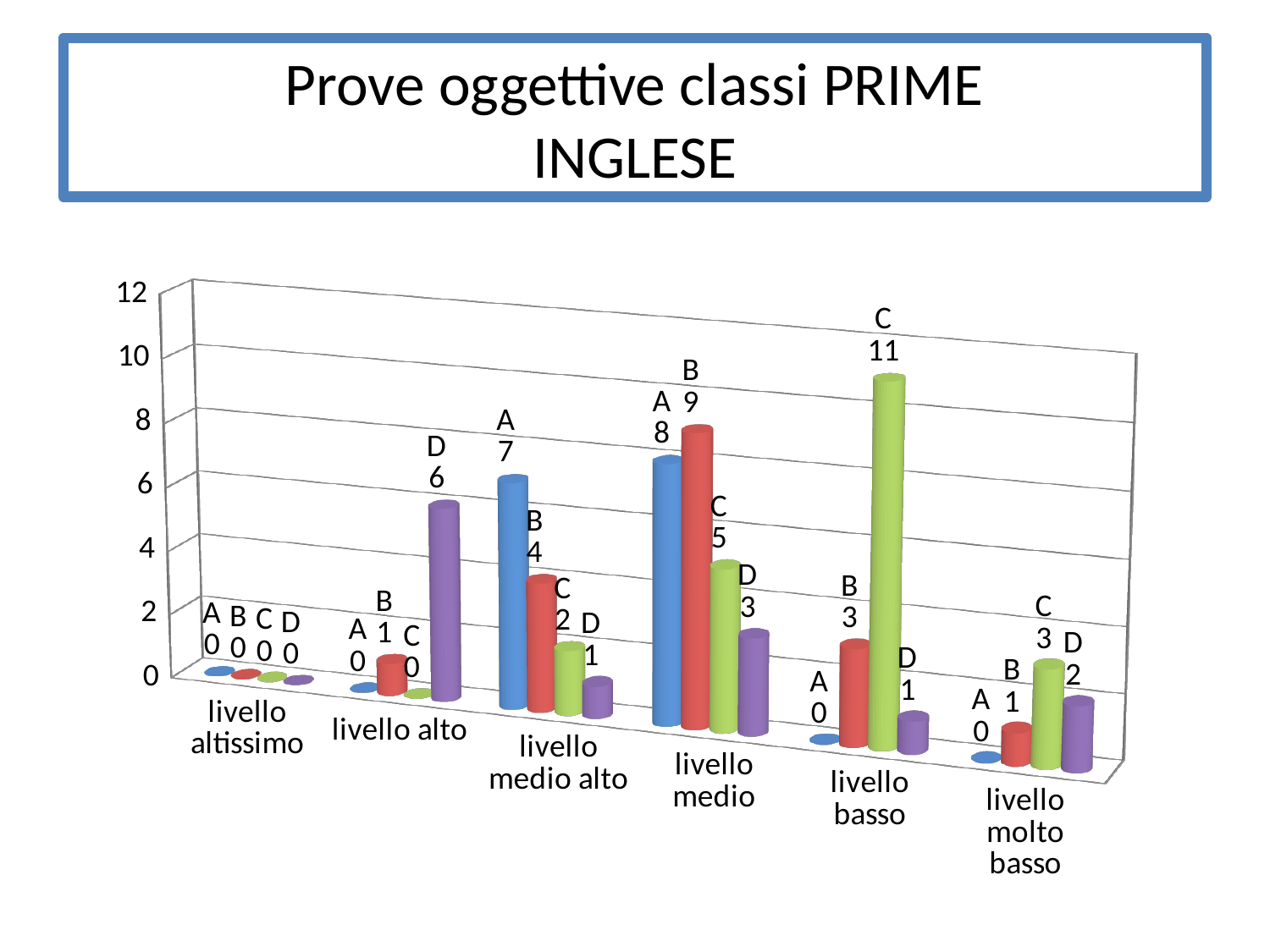
What is the title of the slide containing the chart? Prove oggettive classi PRIME INGLESE Which is larger at livello medio alto: series A or series B? A What is the value for series D at livello alto? 6 What is the difference between series B and series C at livello medio? 4 What is the value for series C at livello basso? 11 What is the value for series A at livello medio alto? 7 Which category has the highest value for series C? livello basso What kind of chart is shown on the slide? bar chart How many categories are shown on the x axis? 6 What is the total of the four series at livello molto basso? 6 What is the value for series B at livello medio? 9 Which series has the highest value at livello medio? B